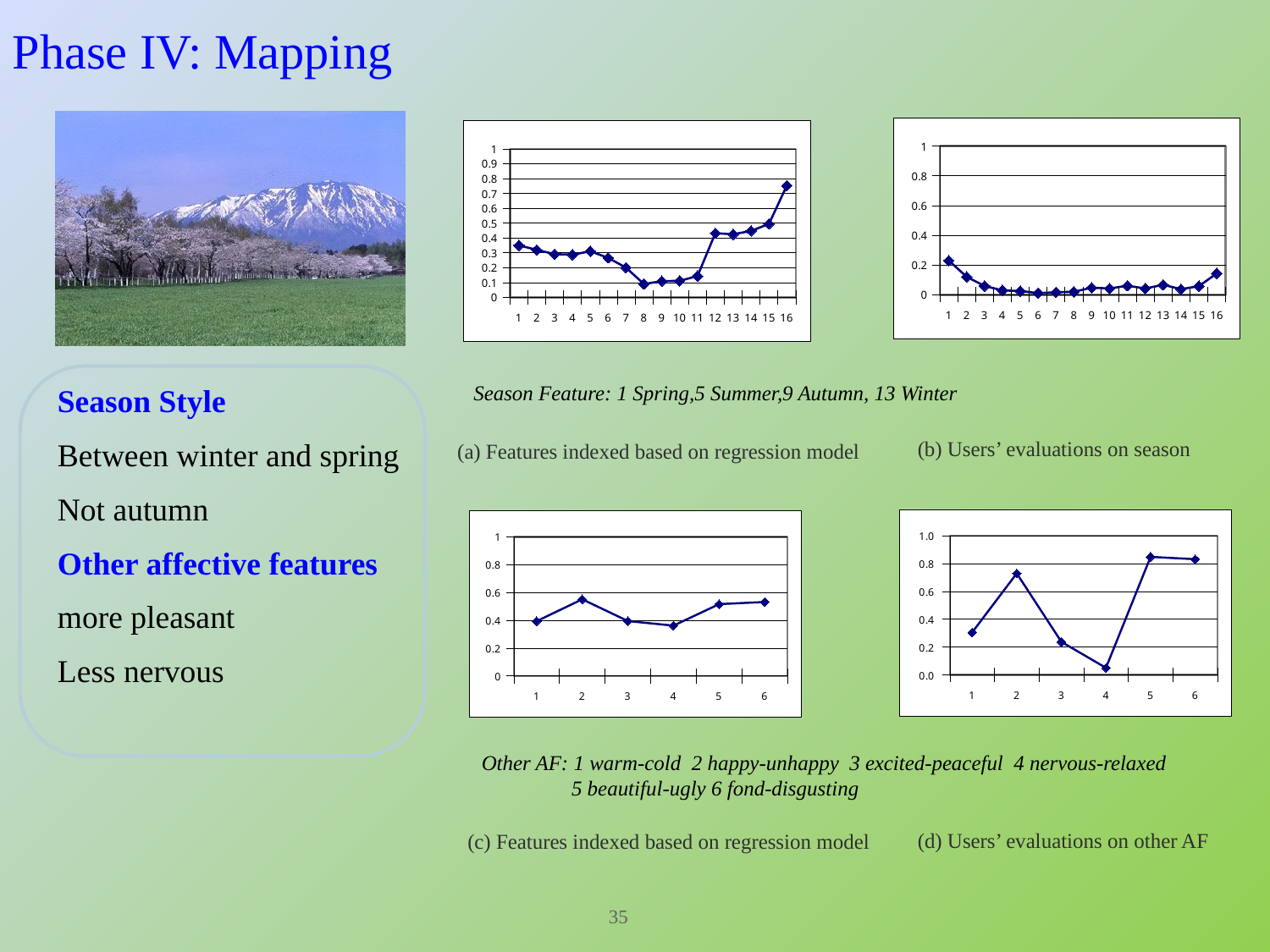
In the bottom-left chart (c), how many points are plotted along the x axis? 6 In the top-left chart (a), which x-axis point has the highest value? 16 In the top-left chart (a), how many points are plotted along the x axis? 16 In the bottom-right chart (d) Users' evaluations on other AF, which x-axis point has the lowest value? 4 In the bottom-left chart (c), is the value at point 2 greater or less than 0.4? greater In the top-right chart (b), is the value at point 1 greater or less than 0.2? greater In the bottom-right chart (d), is the value at point 2 greater or less than 0.6? greater In the top-right chart (b) Users' evaluations on season, which x-axis point has the highest value? 1 In the bottom-right chart (d), does the value rise or fall from point 3 to point 4? fall What kind of chart is the top-left chart, captioned (a) Features indexed based on regression model? line chart